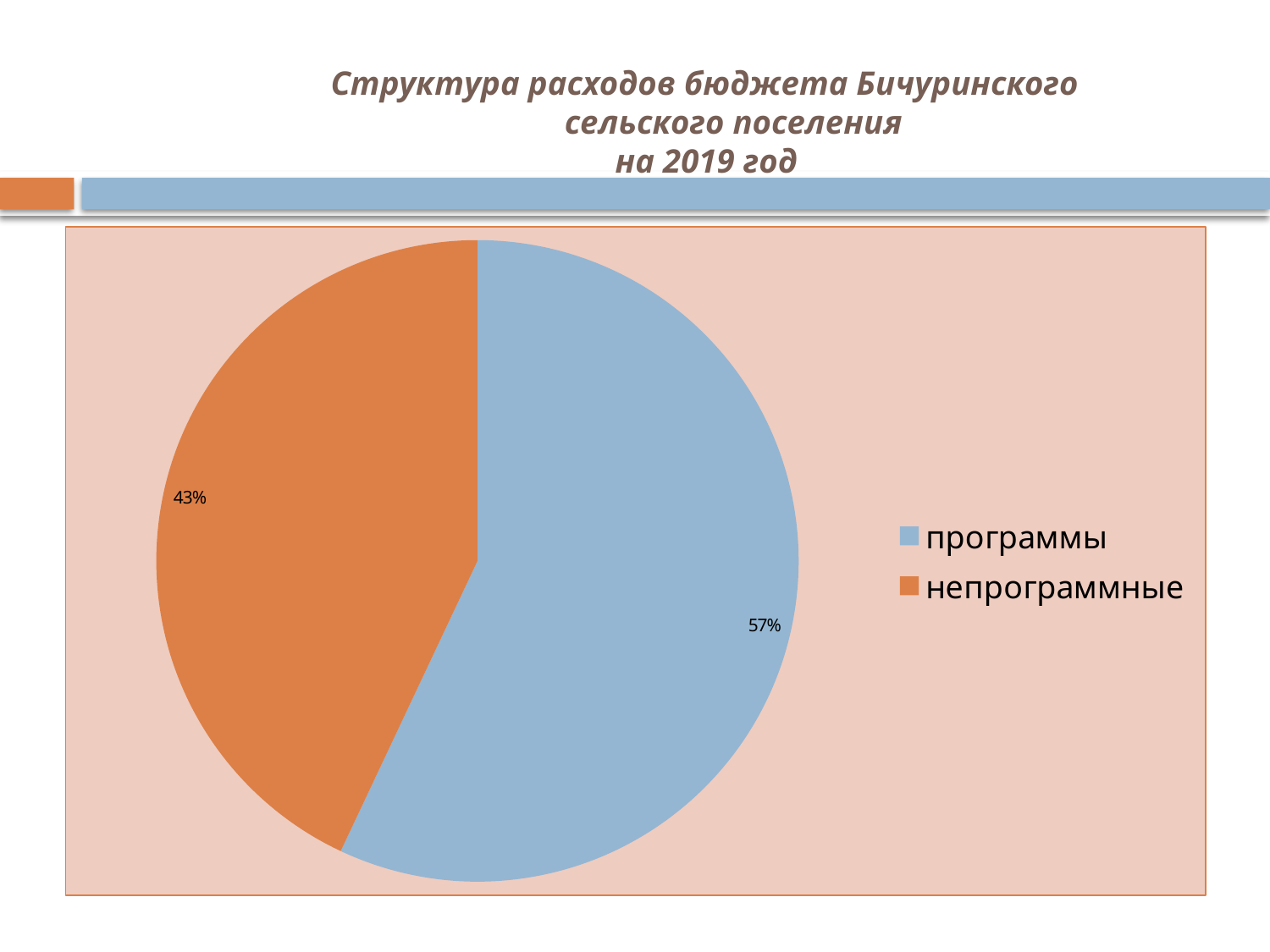
What share of the pie does the "программы" slice represent? 57% What colour is the "непрограммные" slice? orange Which slice is the smallest in the pie chart? непрограммные How many slices does the pie chart have? 2 What colour is the "программы" slice? blue What share of the pie does the "непрограммные" slice represent? 43% Which is larger, the "программы" slice or the "непрограммные" slice? программы What kind of chart is shown on the slide? pie chart What is the difference in percentage points between the "программы" and "непрограммные" slices? 14 Which slice is the largest in the pie chart? программы How many entries does the legend list? 2